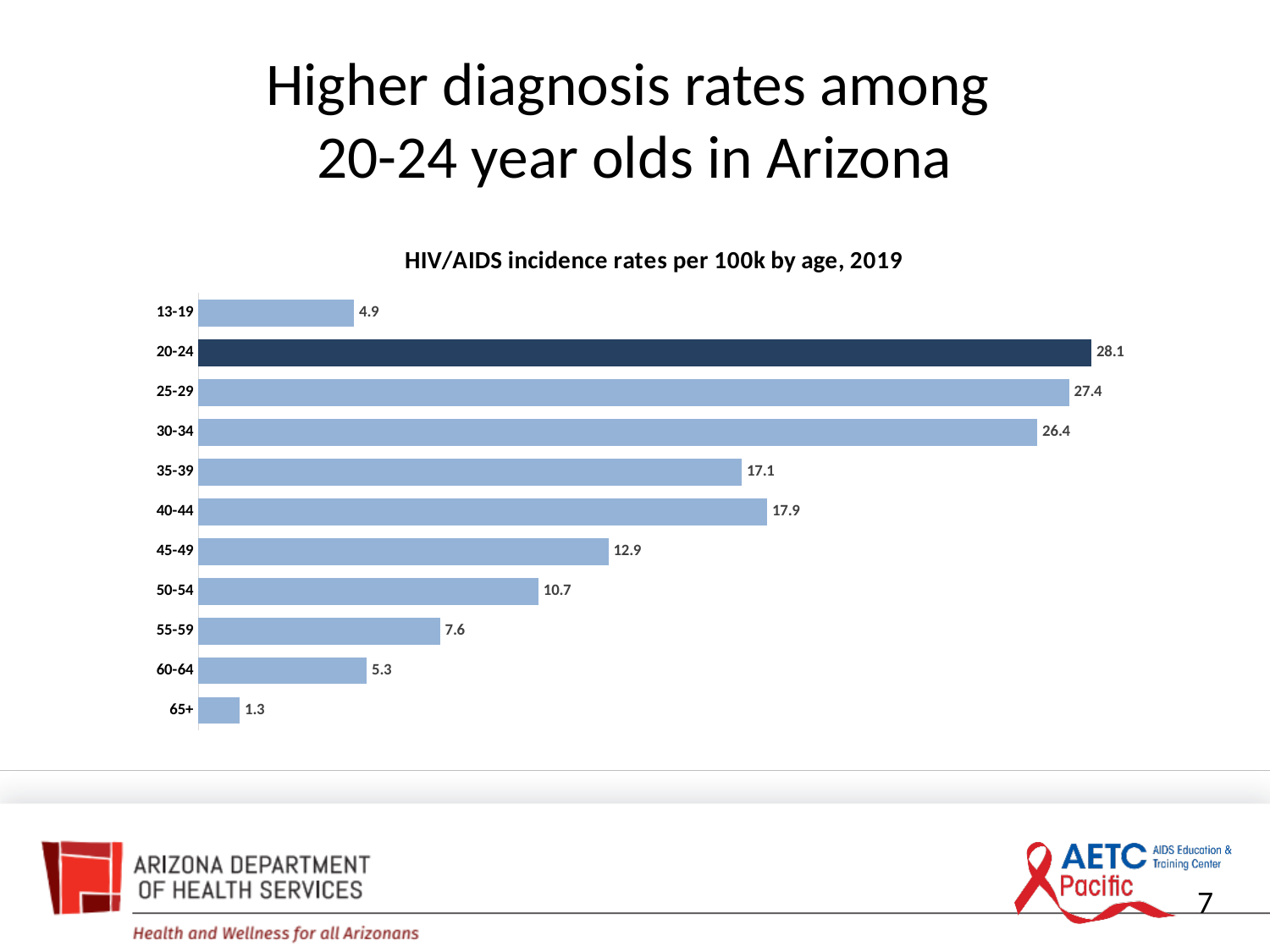
Which age group has the lowest incidence rate? 65+ Which age group has the highest incidence rate? 20-24 Which age group has a higher incidence rate, 13-19 or 55-59? 55-59 What is the difference between the incidence rates for the 30-34 and 60-64 age groups? 21.1 What is the HIV/AIDS incidence rate per 100k for the 20-24 age group? 28.1 What type of chart is shown on the slide? Bar chart Which age group has a higher incidence rate, 35-39 or 40-44? 40-44 What is the difference between the incidence rates for the 20-24 and 25-29 age groups? 0.7 What is the incidence rate for the 65+ age group? 1.3 What is the title of the chart? HIV/AIDS incidence rates per 100k by age, 2019 What is the incidence rate for the 45-49 age group? 12.9 How many age groups are shown in the chart? 11